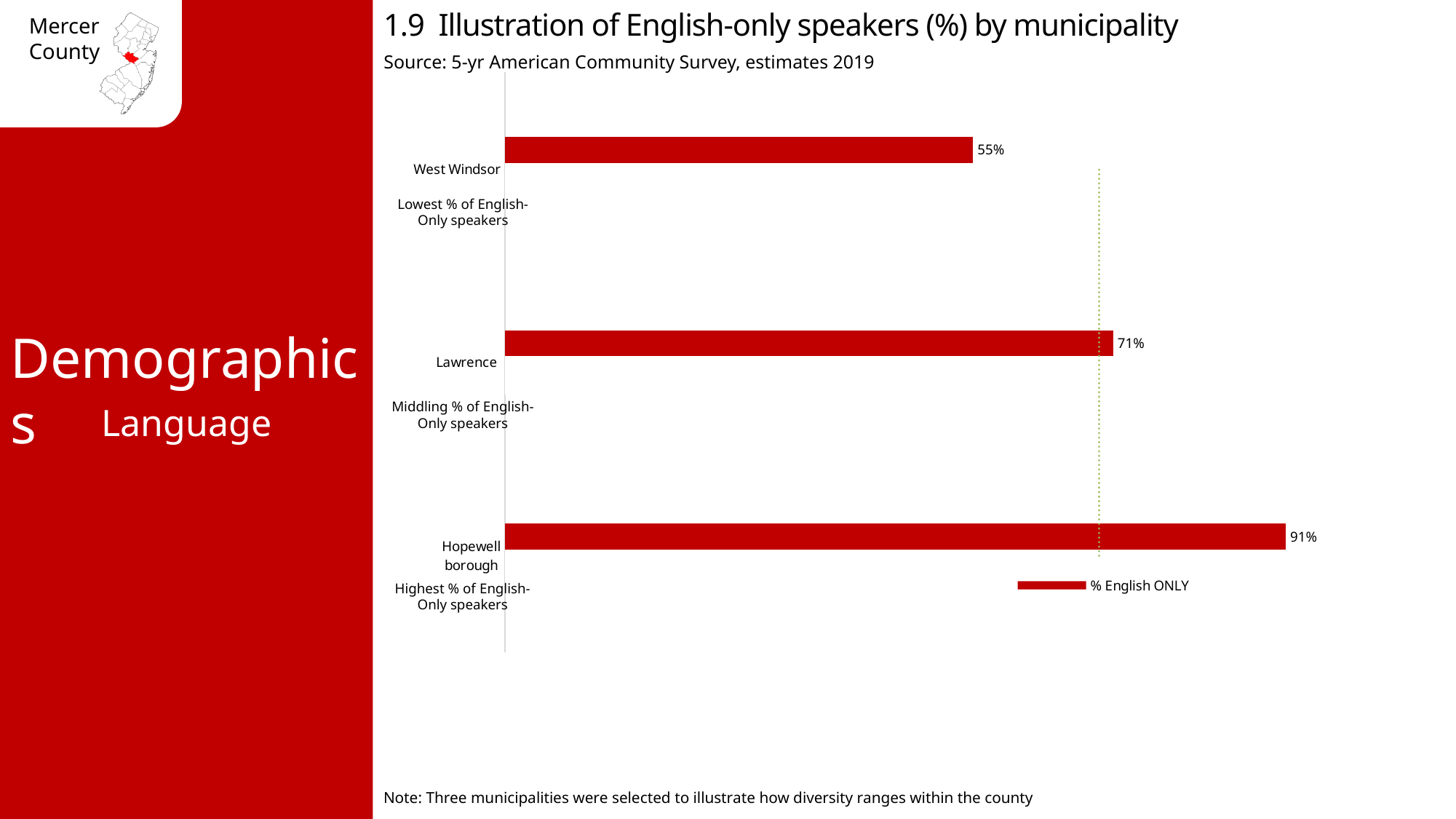
Which municipality has the lowest percentage of English-only speakers? West Windsor What is the difference in percentage points between Lawrence and West Windsor? 16 What kind of chart is shown on the slide? Bar chart Which municipality has the highest percentage of English-only speakers? Hopewell borough What is the percentage of English-only speakers in Hopewell borough? 91% What is the percentage of English-only speakers in Lawrence? 71% How many series does the legend list? 1 What is the legend entry for the series in the chart? % English ONLY How many municipalities are shown in the chart? 3 What is the percentage of English-only speakers in West Windsor? 55% Which has a higher percentage of English-only speakers, Lawrence or West Windsor? Lawrence What is the difference in percentage points between Hopewell borough and West Windsor? 36